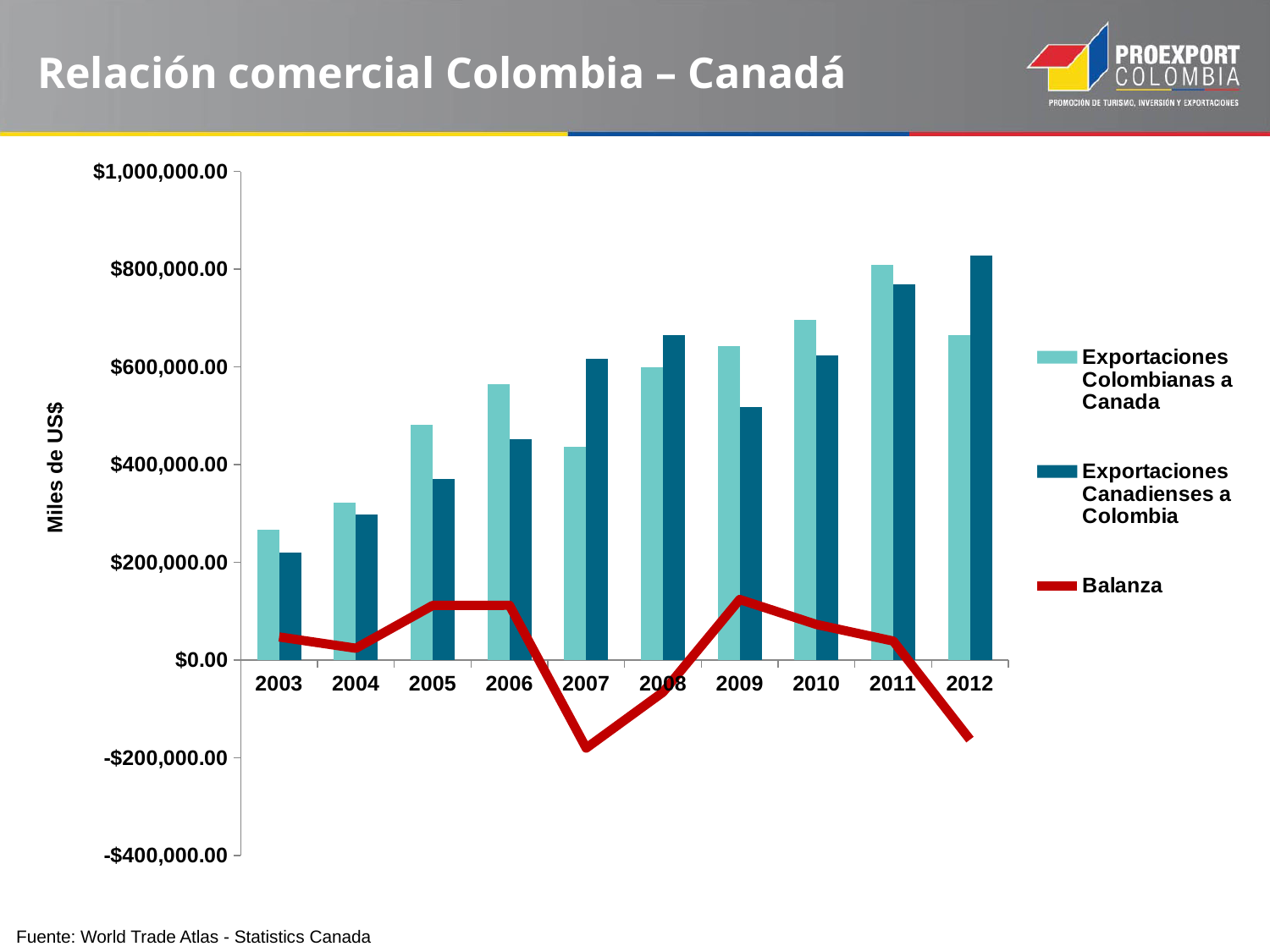
In which year is the Balanza line at its lowest point? 2007 Is the value of Exportaciones Colombianas a Canada in 2011 greater or less than $600,000.00? greater Is the value of Exportaciones Canadienses a Colombia in 2003 greater or less than $400,000.00? less How many years are shown on the x axis? 10 Do Exportaciones Canadienses a Colombia generally rise or fall from 2003 to 2012? rise What is the label on the vertical axis? Miles de US$ In which year are Exportaciones Colombianas a Canada lowest? 2003 In which year are Exportaciones Canadienses a Colombia highest? 2012 In 2007, which is larger: Exportaciones Colombianas a Canada or Exportaciones Canadienses a Colombia? Exportaciones Canadienses a Colombia In which year are Exportaciones Colombianas a Canada highest? 2011 How many series does the legend list? 3 What kind of chart is shown on the slide? A bar chart combined with a line